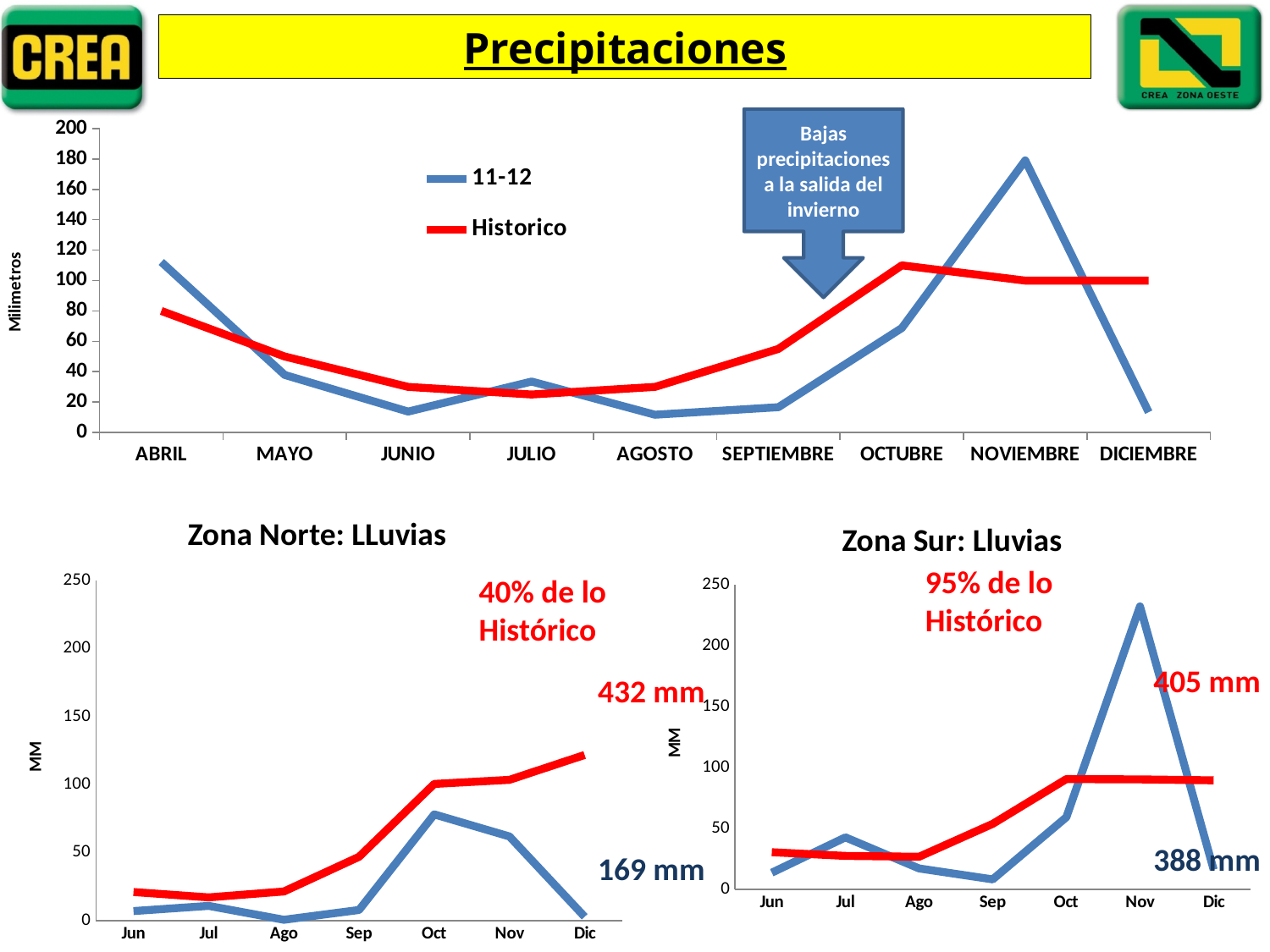
In the top 'Precipitaciones' chart, is the 11-12 value for NOVIEMBRE greater or less than 160? greater In the 'Zona Norte: LLuvias' chart, what total in mm is printed in blue next to the blue line? 169 mm In the top 'Precipitaciones' chart, is the Historico value for ABRIL greater or less than 100? less In the 'Zona Norte: LLuvias' chart, in which month does the blue line reach its highest value? Oct What kind of chart is the top 'Precipitaciones' chart? line chart How many series does the legend of the top 'Precipitaciones' chart list? 2 How many months are shown on the x axis of the top 'Precipitaciones' chart? 9 In the top 'Precipitaciones' chart, which series has the larger value in ABRIL, 11-12 or Historico? 11-12 In the top 'Precipitaciones' chart, in which month does the 11-12 series reach its highest value? NOVIEMBRE In the top 'Precipitaciones' chart, which series has the larger value in SEPTIEMBRE, 11-12 or Historico? Historico What percentage of the historical value is printed on the 'Zona Sur: Lluvias' chart? 95% de lo Histórico In the 'Zona Sur: Lluvias' chart, is the blue line's value for Nov greater or less than 200? greater